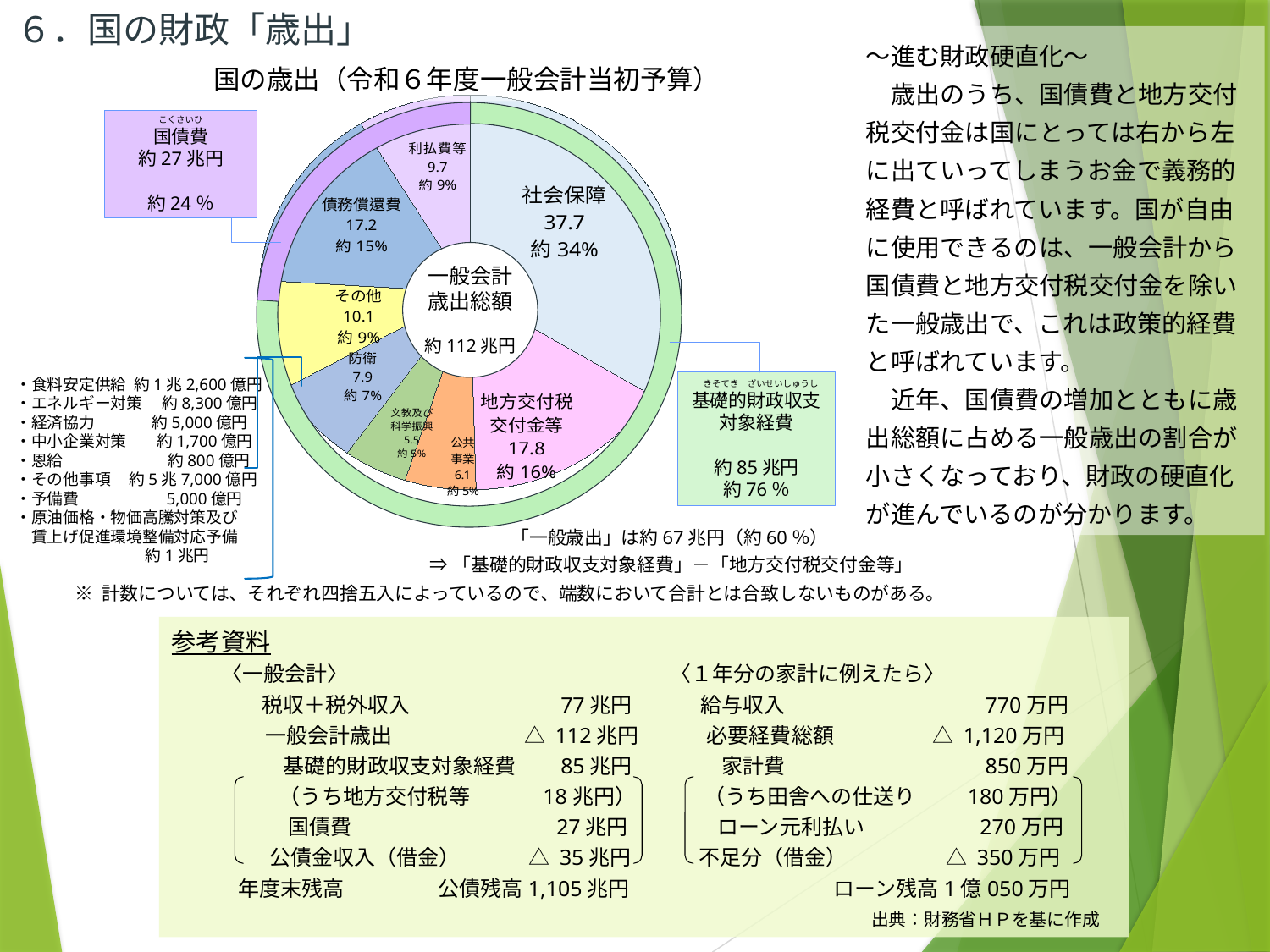
What is the value shown for 社会保障 in the chart? 37.7 Which category has the smallest slice in the chart? 文教及び科学振興 What is the title of the chart? 国の歳出（令和６年度一般会計当初予算） What percentage share is shown for 地方交付税交付金等? 約 16% What percentage share is shown for 利払費等? 約 9% Which is larger, the value for 防衛 or the value for 公共事業? 防衛 What kind of chart is shown on the slide? pie chart How many categories (slices) does the chart have? 8 What is the value shown for 債務償還費? 17.2 Which category has the largest slice in the chart? 社会保障 What is the difference between the values for 社会保障 and 地方交付税交付金等? 19.9 What total is shown in the centre of the chart for 一般会計歳出総額? 約 112 兆円